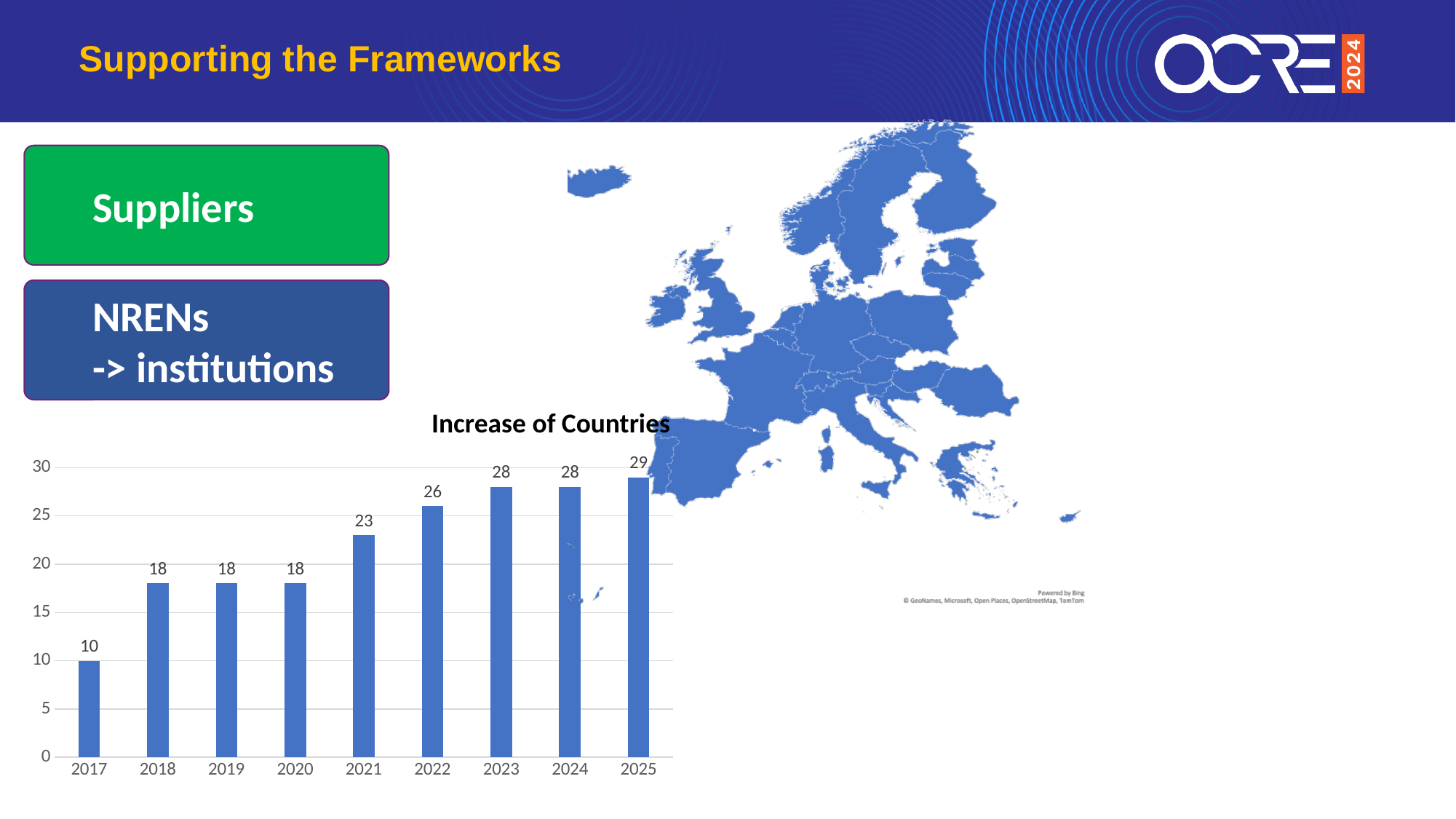
How many years are shown on the x axis of the Increase of Countries chart? 9 Is the value for 2023 in the Increase of Countries chart greater or less than 25? greater What is the value for 2021 in the Increase of Countries chart? 23 Do the values in the Increase of Countries chart generally rise or fall from 2017 to 2025? rise What is the difference between the values for 2022 and 2021 in the Increase of Countries chart? 3 What kind of chart is the Increase of Countries chart? bar chart Which year has the lowest value in the Increase of Countries chart? 2017 What is the value for 2017 in the Increase of Countries chart? 10 What is the value for 2025 in the Increase of Countries chart? 29 Which is larger in the Increase of Countries chart, the value for 2020 or the value for 2022? 2022 Which year has the highest value in the Increase of Countries chart? 2025 What is the difference between the values for 2025 and 2017 in the Increase of Countries chart? 19